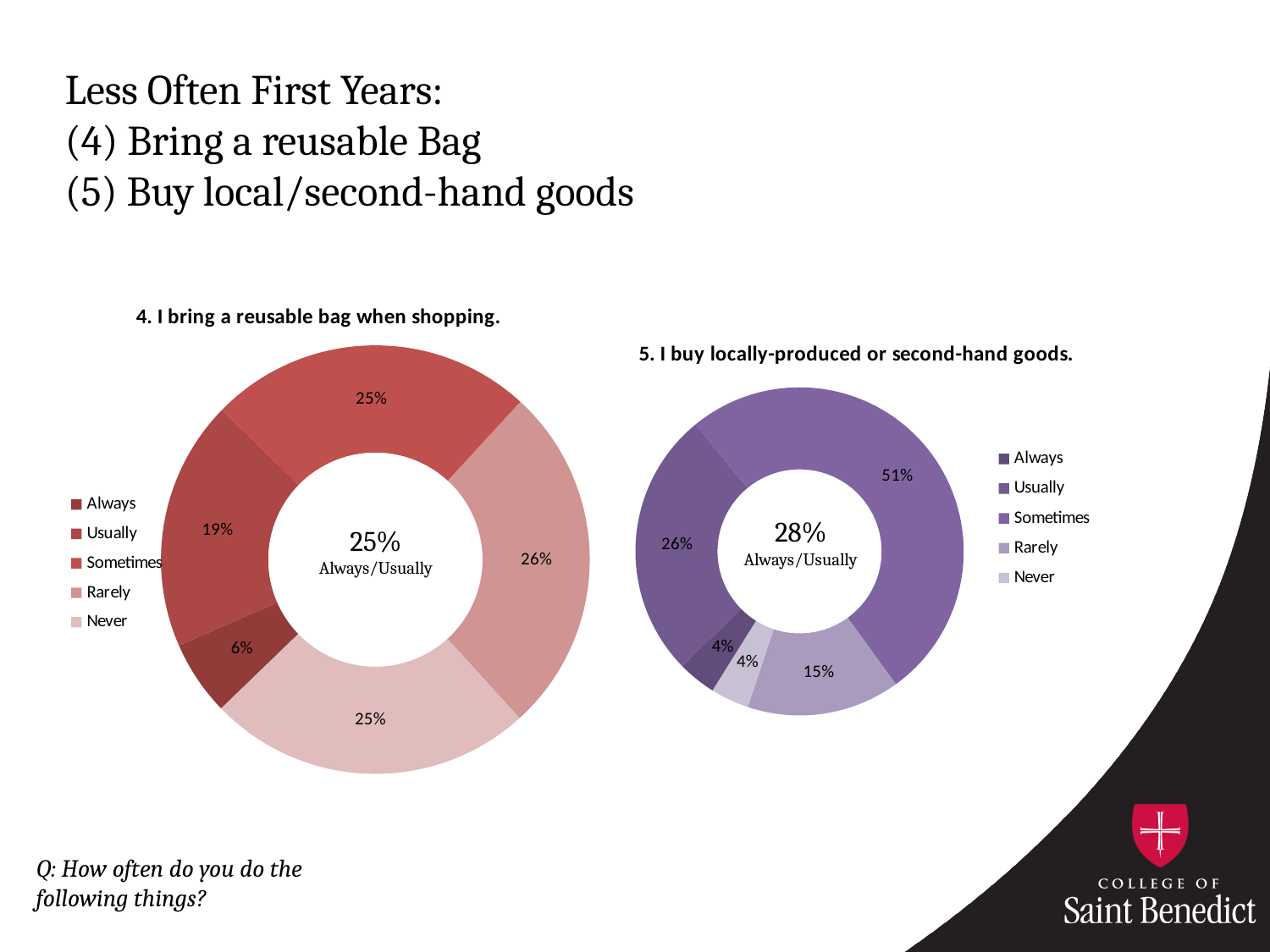
In the chart titled "5. I buy locally-produced or second-hand goods.", which category has the largest share? Sometimes In the chart titled "5. I buy locally-produced or second-hand goods.", which is larger, Usually or Rarely? Usually How many categories does the legend of the chart titled "5. I buy locally-produced or second-hand goods." list? 5 In the chart titled "5. I buy locally-produced or second-hand goods.", what percentage is shown for Rarely? 15% In the chart titled "4. I bring a reusable bag when shopping.", what percentage is shown for Usually? 19% In the chart titled "5. I buy locally-produced or second-hand goods.", what percentage is shown for Sometimes? 51% In the chart titled "4. I bring a reusable bag when shopping.", which category has the smallest share? Always In the chart titled "4. I bring a reusable bag when shopping.", what percentage is shown for Always? 6% In the chart titled "4. I bring a reusable bag when shopping.", what is the difference between the Usually and Always percentages? 13% In the chart titled "4. I bring a reusable bag when shopping.", what combined Always/Usually percentage is printed in the centre of the doughnut? 25% What type of chart is used for "4. I bring a reusable bag when shopping."? Doughnut (pie) chart In the chart titled "5. I buy locally-produced or second-hand goods.", what is the difference between the Sometimes and Usually percentages? 25%